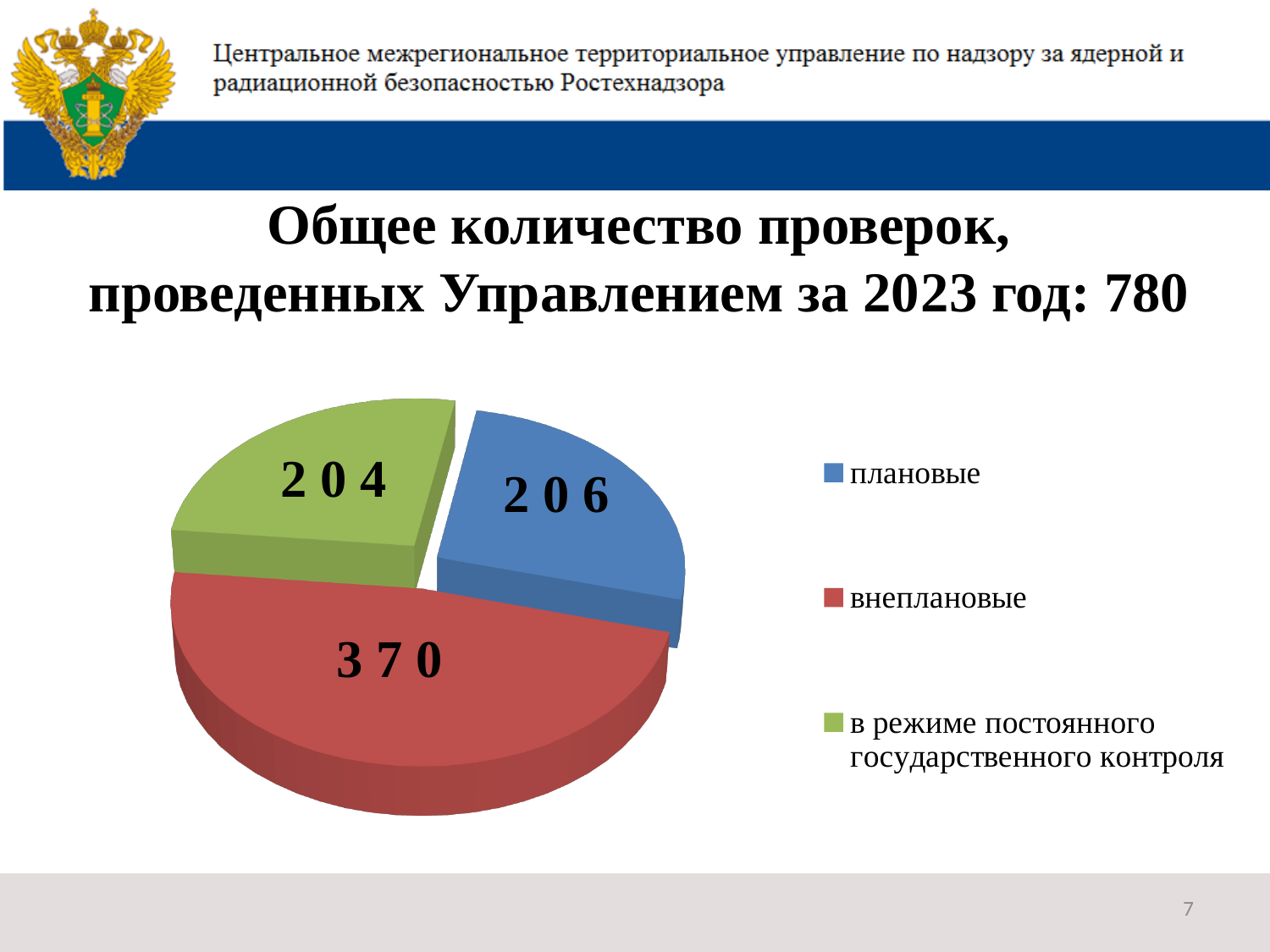
Which category has the largest slice? внеплановые What kind of chart is shown on the slide? pie chart How many slices does the pie chart have? 3 What share of the total do внеплановые checks represent? 47.4% What is the value for плановые? 206 What is the difference between внеплановые and плановые? 164 What is the value for внеплановые? 370 What is the value for в режиме постоянного государственного контроля? 204 Which category has the smallest slice? в режиме постоянного государственного контроля How many entries does the legend list? 3 What colour is the slice for внеплановые? red Which is larger, плановые or в режиме постоянного государственного контроля? плановые